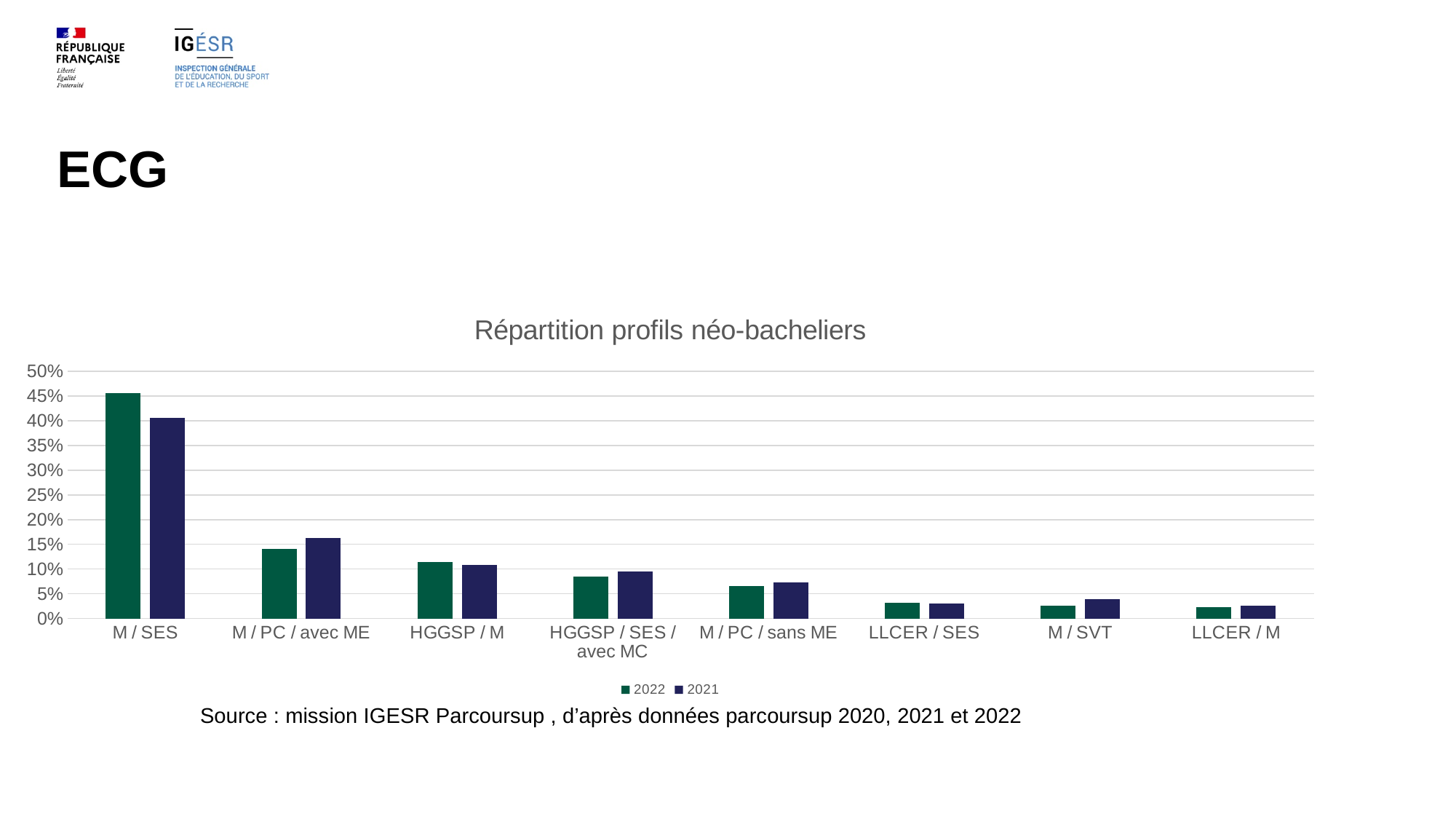
What is the title of the chart? Répartition profils néo-bacheliers Is the 2022 value for HGGSP / M greater or less than 10%? greater Is the 2022 value for M / SES greater or less than 40%? greater Is the 2021 value for M / SES greater or less than 45%? less For M / SES, which year has the larger value, 2022 or 2021? 2022 Do the 2022 values generally rise or fall from left to right along the x axis? fall For M / PC / avec ME, which year has the larger value, 2022 or 2021? 2021 What kind of chart is shown on the slide? bar chart How many series does the legend list? 2 Which category has the highest value for 2022? M / SES How many profile categories are shown on the x axis? 8